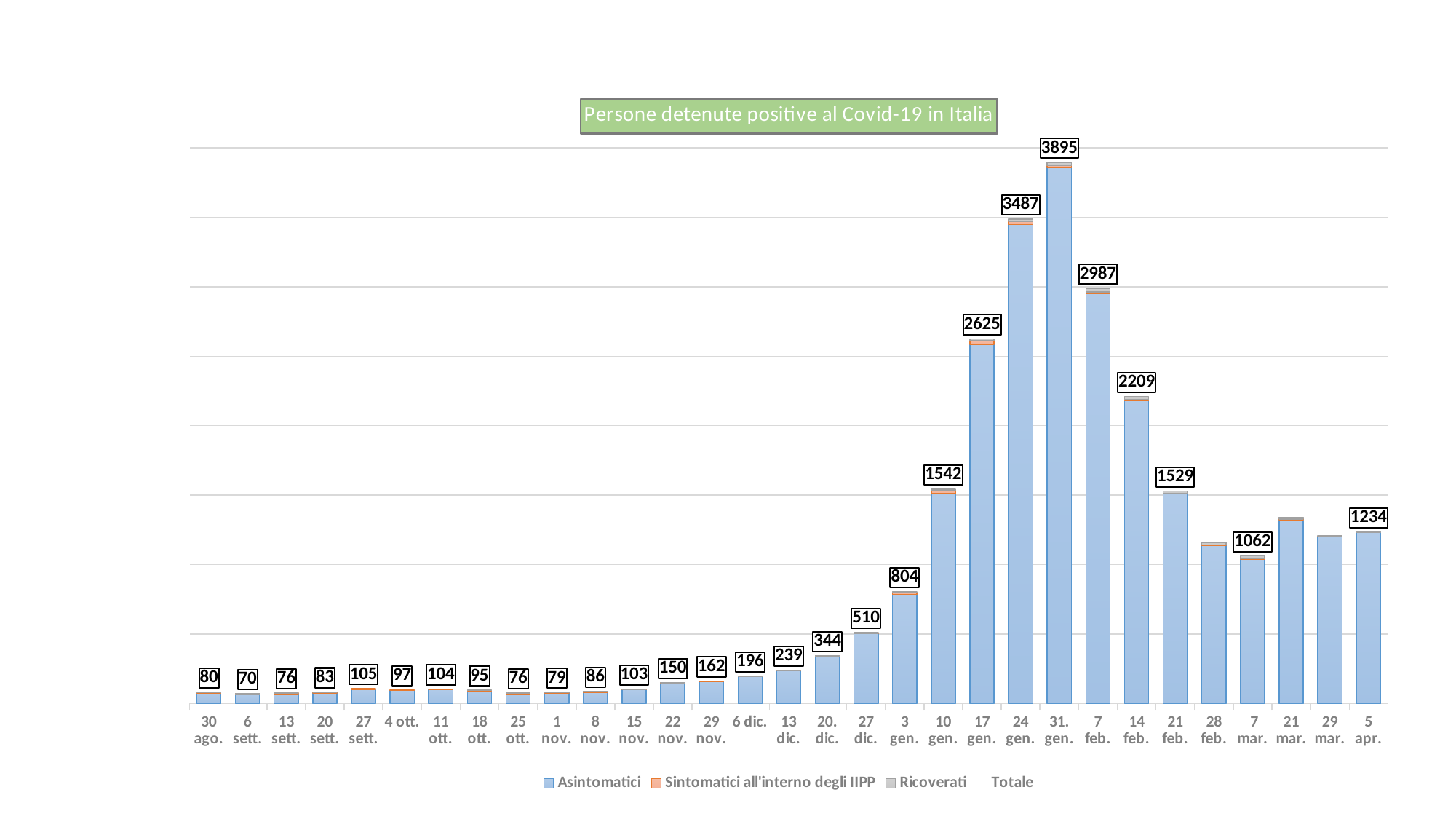
Which has a larger total, 7 feb. or 14 feb.? 7 feb. What is the difference between the totals for 31 gen. and 24 gen.? 408 What kind of chart is this? Stacked bar chart Which date has the lowest total? 6 sett. How many entries does the legend list? 4 What is the total value shown for 27 dic.? 510 What is the title of the chart? Persone detenute positive al Covid-19 in Italia What is the total value shown for 31 gen.? 3895 How many dates are shown on the x axis? 31 Do the totals rise or fall from 6 dic. to 31 gen.? Rise What is the total value shown for 5 apr.? 1234 Which date has the highest total? 31 gen.